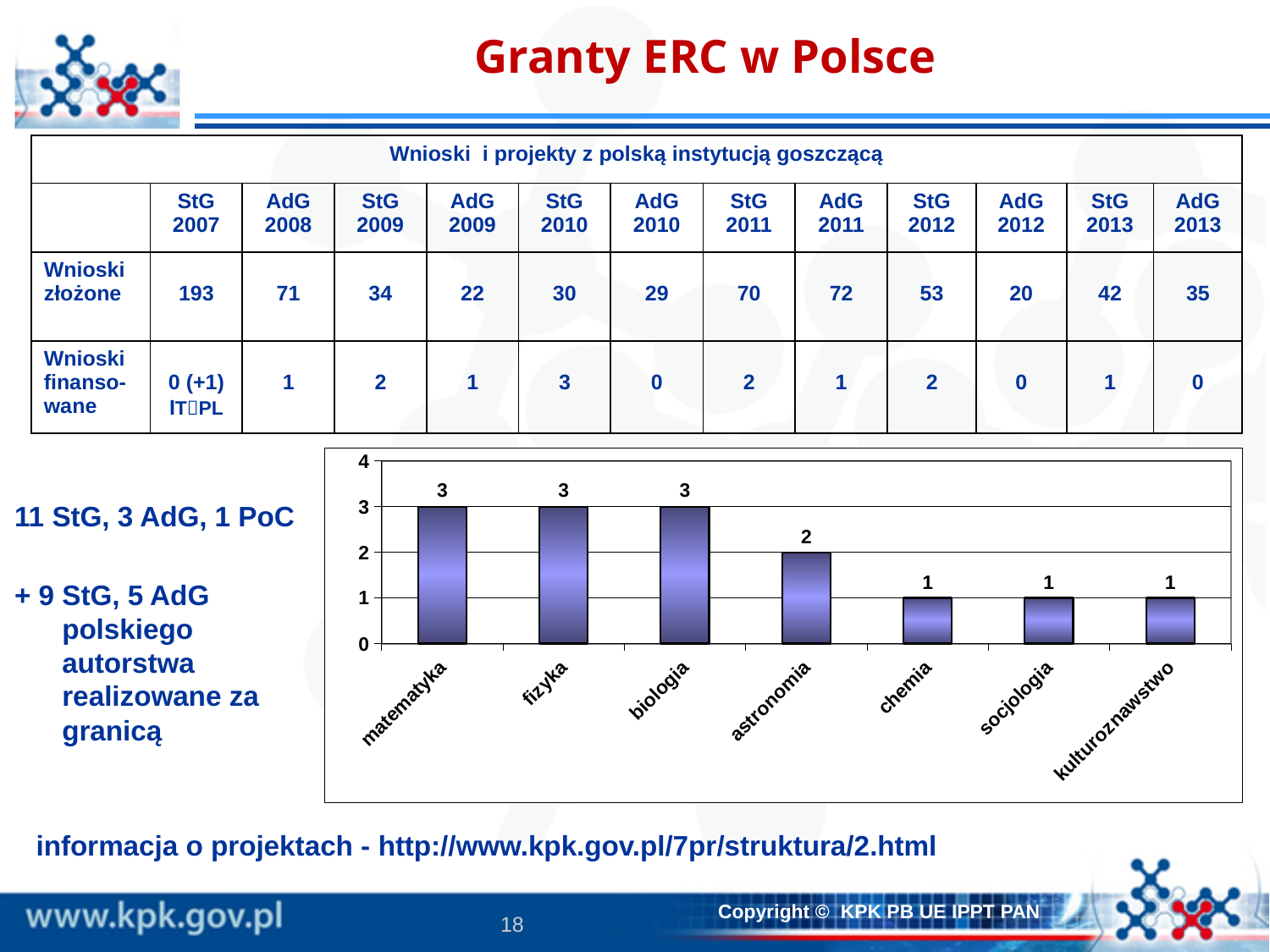
Do the values in the bar chart rise or fall from left to right along the x axis? fall How many categories are shown on the x axis of the bar chart? 7 Is the value for biologia in the bar chart greater or less than 2? greater What is the value for matematyka in the bar chart? 3 What is the difference between the values for biologia and chemia in the bar chart? 2 What is the value for chemia in the bar chart? 1 What is the value for kulturoznawstwo in the bar chart? 1 Which category has the lowest value in the bar chart: astronomia or socjologia? socjologia What is the difference between the values for fizyka and astronomia in the bar chart? 1 What kind of chart is shown on the slide? bar chart Which is larger in the bar chart, the value for astronomia or the value for socjologia? astronomia What is the value for astronomia in the bar chart? 2